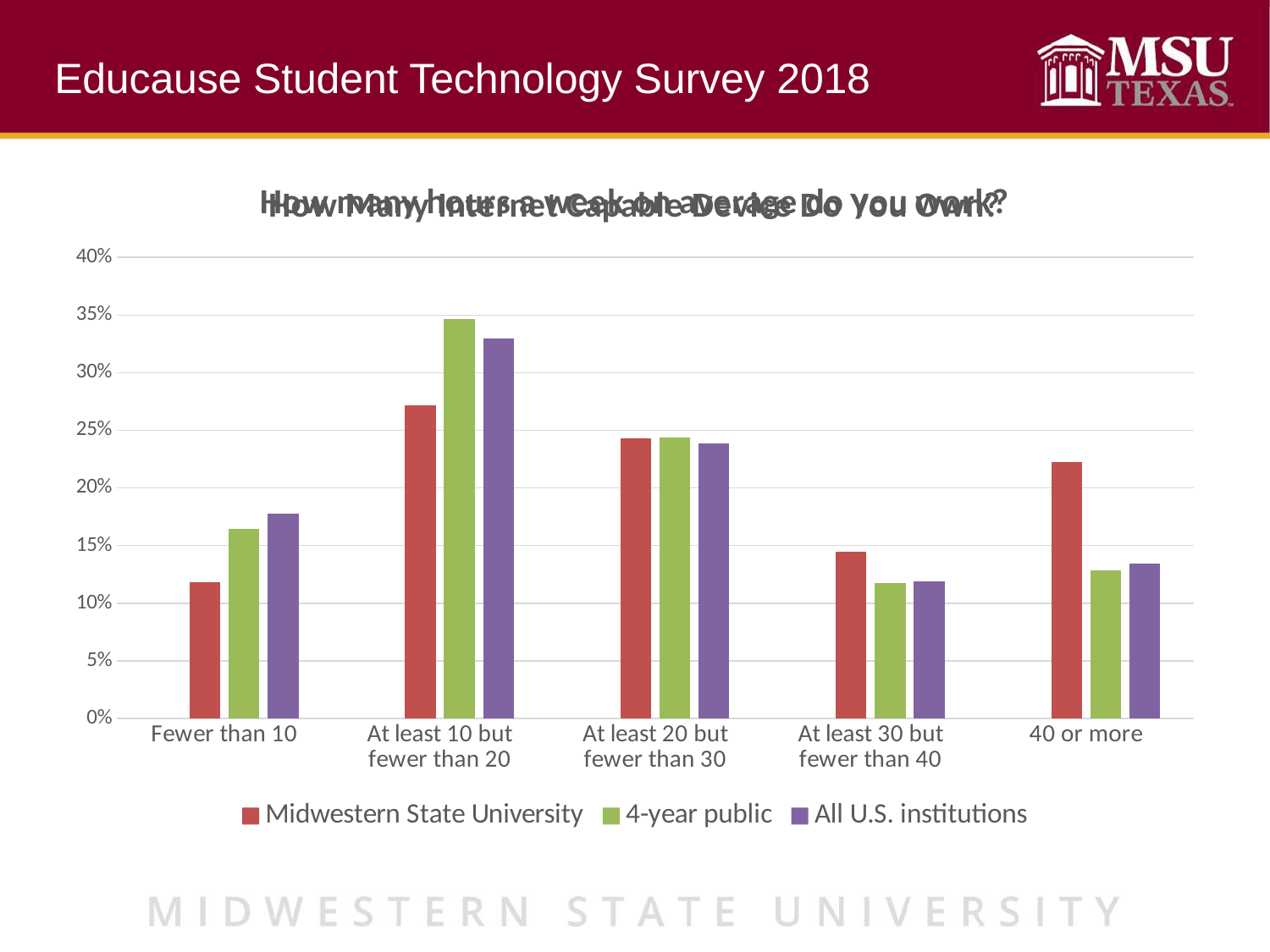
Which series has the tallest bar in the whole chart? 4-year public Is the All U.S. institutions value for 'Fewer than 10' greater or less than 20%? less How many categories are shown along the x axis of the chart? 5 Is the 4-year public value for 'At least 10 but fewer than 20' greater or less than 30%? greater What kind of chart is shown on the slide? bar chart What colour are the Midwestern State University bars in the chart? red Is the Midwestern State University value for '40 or more' greater or less than 20%? greater For 'Fewer than 10', which is larger: Midwestern State University or All U.S. institutions? All U.S. institutions How many series does the chart's legend list? 3 For which category is the Midwestern State University bar the lowest? Fewer than 10 For which category is the Midwestern State University bar the highest? At least 10 but fewer than 20 For '40 or more', which is larger: Midwestern State University or 4-year public? Midwestern State University